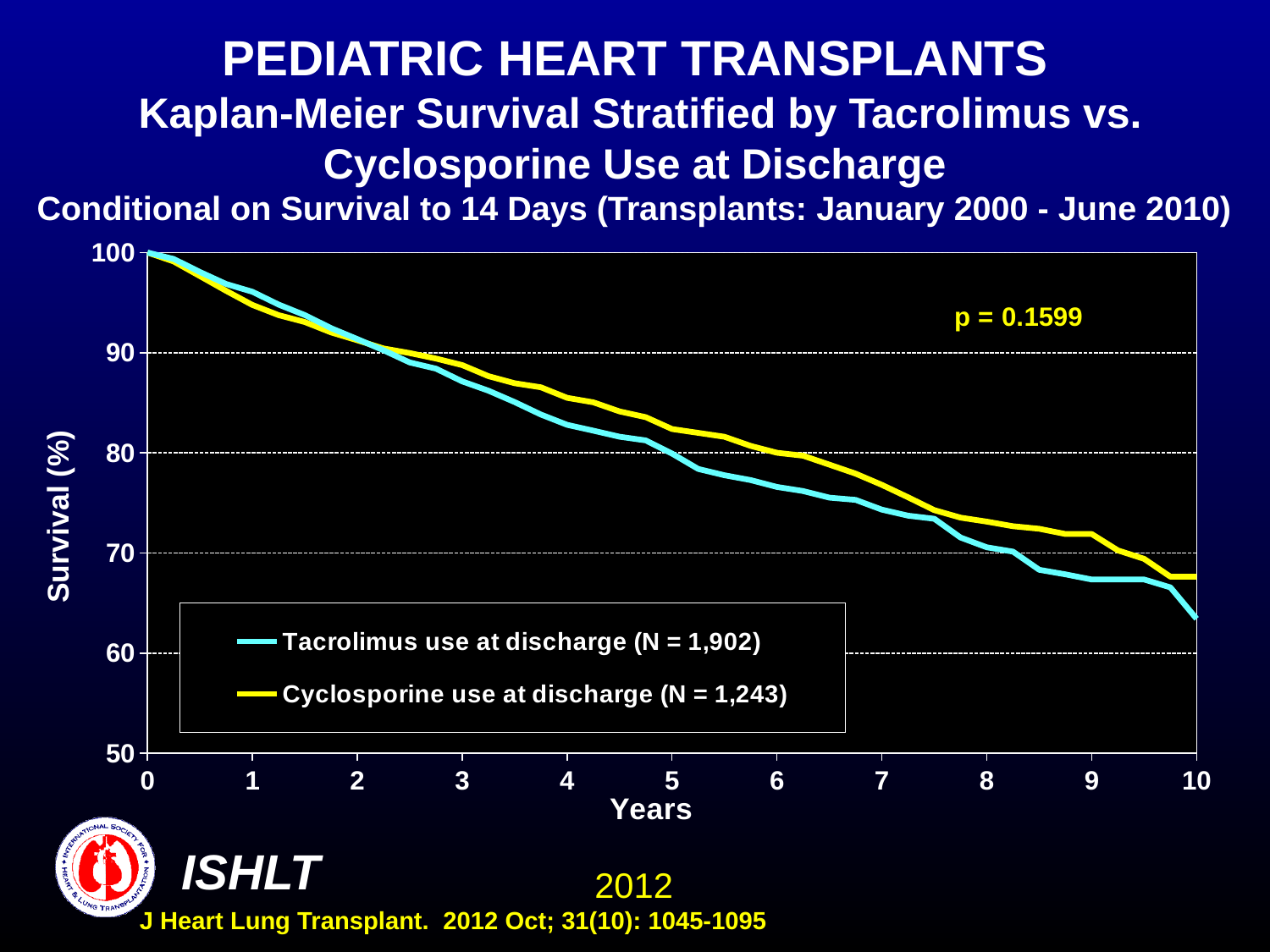
What is the N for the Tacrolimus use at discharge group? 1,902 How many series does the legend list? 2 Which colour represents Cyclosporine use at discharge? Yellow What is the p-value shown on the chart? p = 0.1599 What kind of chart is shown on the slide? Line chart At 2 years, is survival for Cyclosporine use at discharge greater or less than 90? greater At 10 years, which group has higher survival, Tacrolimus or Cyclosporine use at discharge? Cyclosporine use at discharge Do the survival curves rise or fall as years increase? Fall At 8 years, which group has higher survival, Tacrolimus or Cyclosporine use at discharge? Cyclosporine use at discharge At 3 years, is survival for Tacrolimus use at discharge greater or less than 80? greater What is the N for the Cyclosporine use at discharge group? 1,243 At 10 years, is survival for Tacrolimus use at discharge greater or less than 70? less